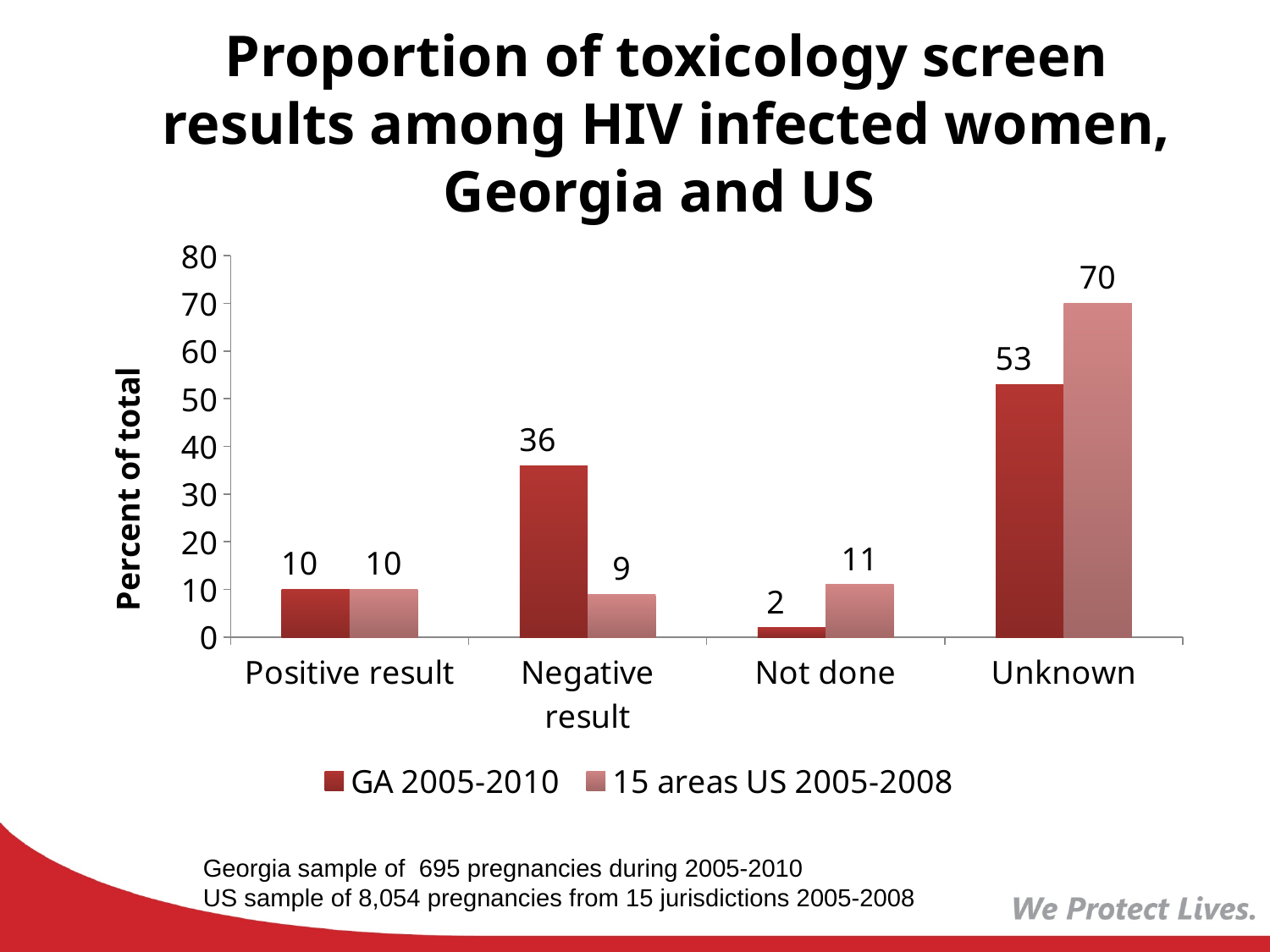
What is the value for Negative result in the GA 2005-2010 series? 36 What is the value for Unknown in the 15 areas US 2005-2008 series? 70 What is the difference between the GA 2005-2010 and 15 areas US 2005-2008 values for Unknown? 17 What is the difference between the GA 2005-2010 and 15 areas US 2005-2008 values for Not done? 9 Which category has the highest value in the GA 2005-2010 series? Unknown Which is larger for Negative result: GA 2005-2010 or 15 areas US 2005-2008? GA 2005-2010 Which category has the lowest value in the 15 areas US 2005-2008 series? Negative result What is the label of the y axis? Percent of total What kind of chart is shown on the slide? Bar chart What is the value for Not done in the GA 2005-2010 series? 2 How many categories are shown on the x axis? 4 How many series does the legend list? 2